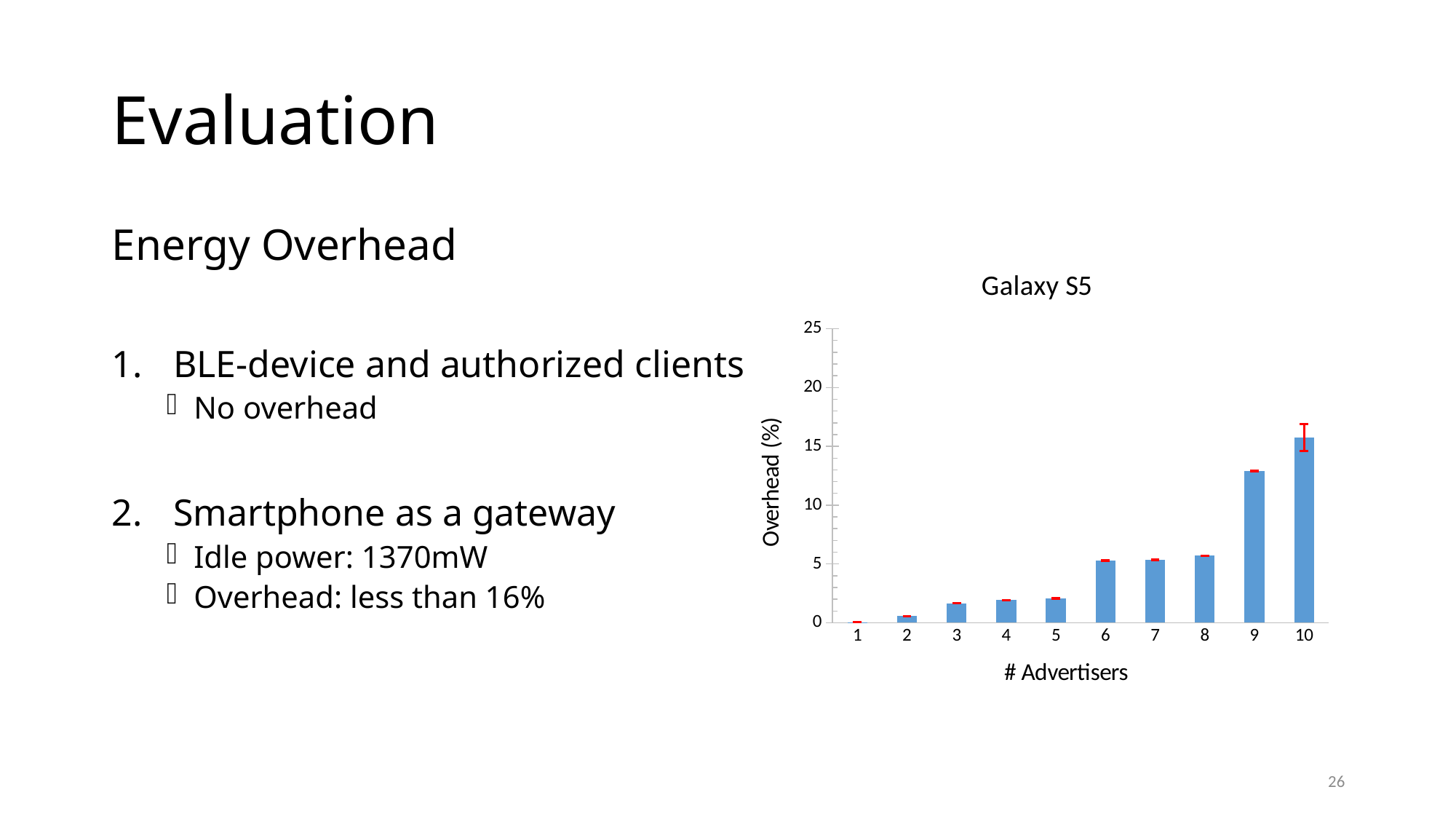
Which number of advertisers has the lowest overhead? 1 What is the label of the y axis of the chart? Overhead (%) Is the overhead for 9 advertisers greater or less than 10? greater Is the overhead for 5 advertisers greater or less than 5? less What is the title of the chart? Galaxy S5 How many bars (advertiser counts) are plotted in the chart? 10 Is the overhead for 10 advertisers greater or less than 15? greater Which number of advertisers has the highest overhead? 10 Which has the larger overhead, 8 advertisers or 9 advertisers? 9 advertisers Does the overhead generally rise or fall as the number of advertisers increases? rise What kind of chart is shown on the slide? bar chart